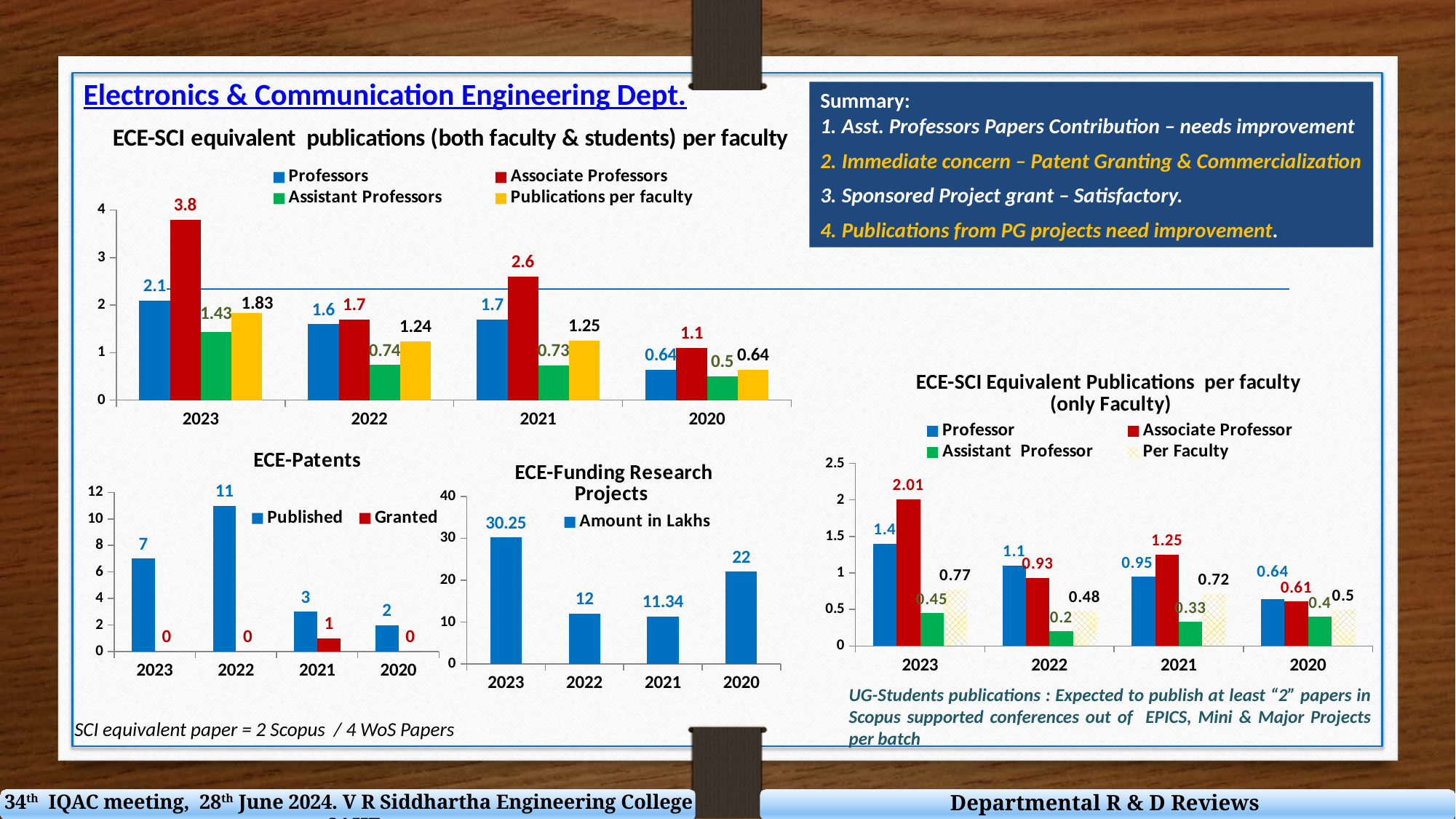
In the ECE-SCI Equivalent Publications per faculty (only Faculty) chart, what is the difference between Associate Professor and Professor in 2023? 0.61 In the ECE-Funding Research Projects chart, what is the amount in lakhs for 2023? 30.25 In the ECE-Funding Research Projects chart, what is the difference between the amounts for 2020 and 2022? 10 In the ECE-SCI equivalent publications (both faculty & students) per faculty chart, how many series does the legend list? 4 In the ECE-Patents chart, how many patents were granted in 2021? 1 In the ECE-Patents chart, which year has the highest number of published patents? 2022 In the ECE-SCI equivalent publications (both faculty & students) per faculty chart, which is larger in 2022: Professors or Associate Professors? Associate Professors What type of chart is the ECE-Funding Research Projects chart? Bar chart In the ECE-SCI Equivalent Publications per faculty (only Faculty) chart, what is the value for Assistant Professor in 2022? 0.2 In the ECE-SCI equivalent publications (both faculty & students) per faculty chart, what is the value for Associate Professors in 2023? 3.8 In the ECE-Funding Research Projects chart, which year has the lowest amount in lakhs? 2021 In the ECE-Patents chart, how many patents were published in 2022? 11